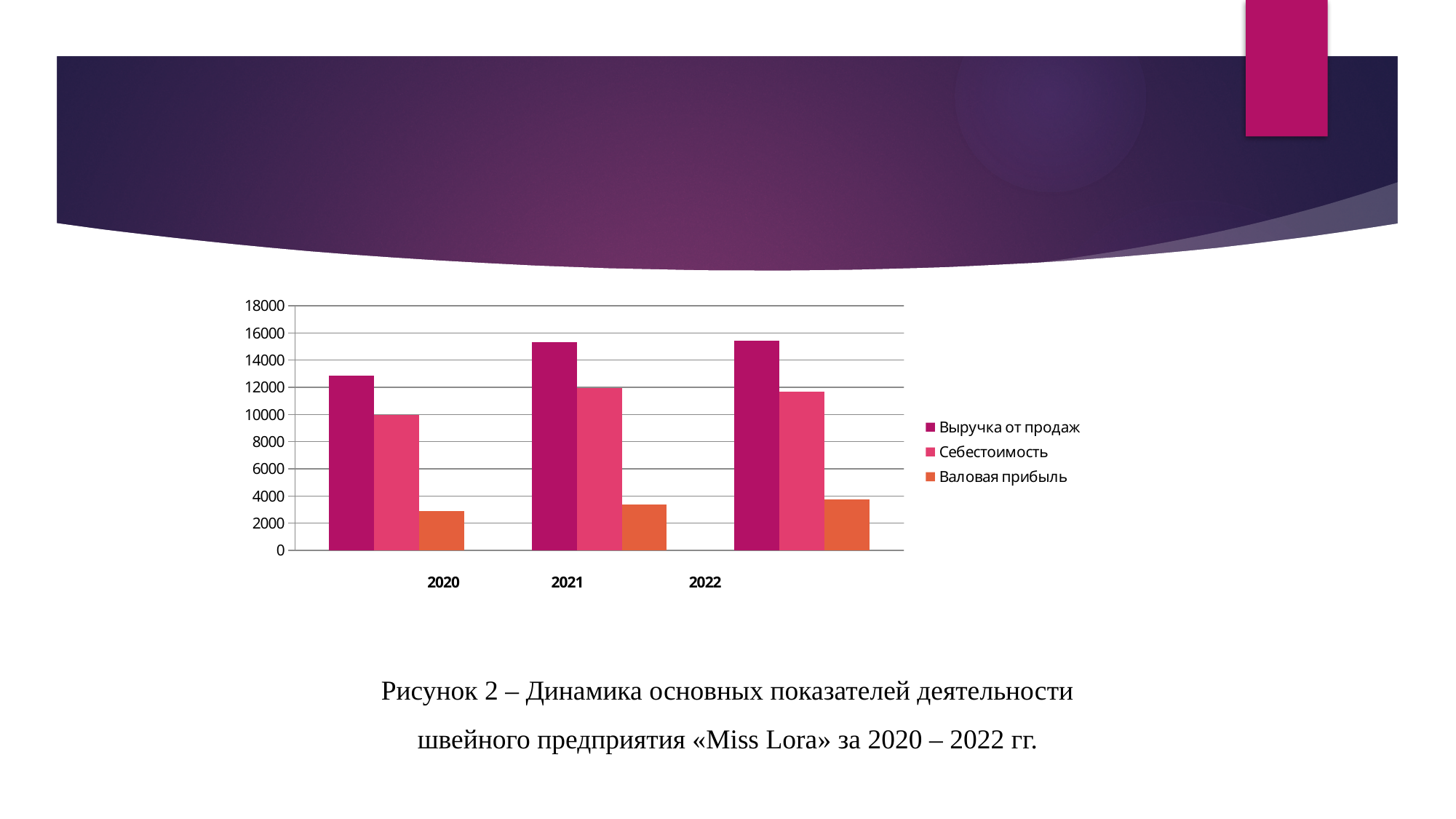
Is the value for Выручка от продаж in 2021 greater or less than 14000? greater In 2020, which is larger: Выручка от продаж or Себестоимость? Выручка от продаж What kind of chart is shown on the slide? Bar chart Is the value for Себестоимость in 2022 greater or less than 12000? less Which year has the lowest value for Себестоимость? 2020 How many series does the chart's legend list? 3 Which year has the highest value for Валовая прибыль? 2022 Which year has the lowest value for Выручка от продаж? 2020 Does the value for Валовая прибыль rise or fall from 2020 to 2022? Rises Is the value for Валовая прибыль in 2020 greater or less than 4000? less How many years (categories) are shown on the x axis of the chart? 3